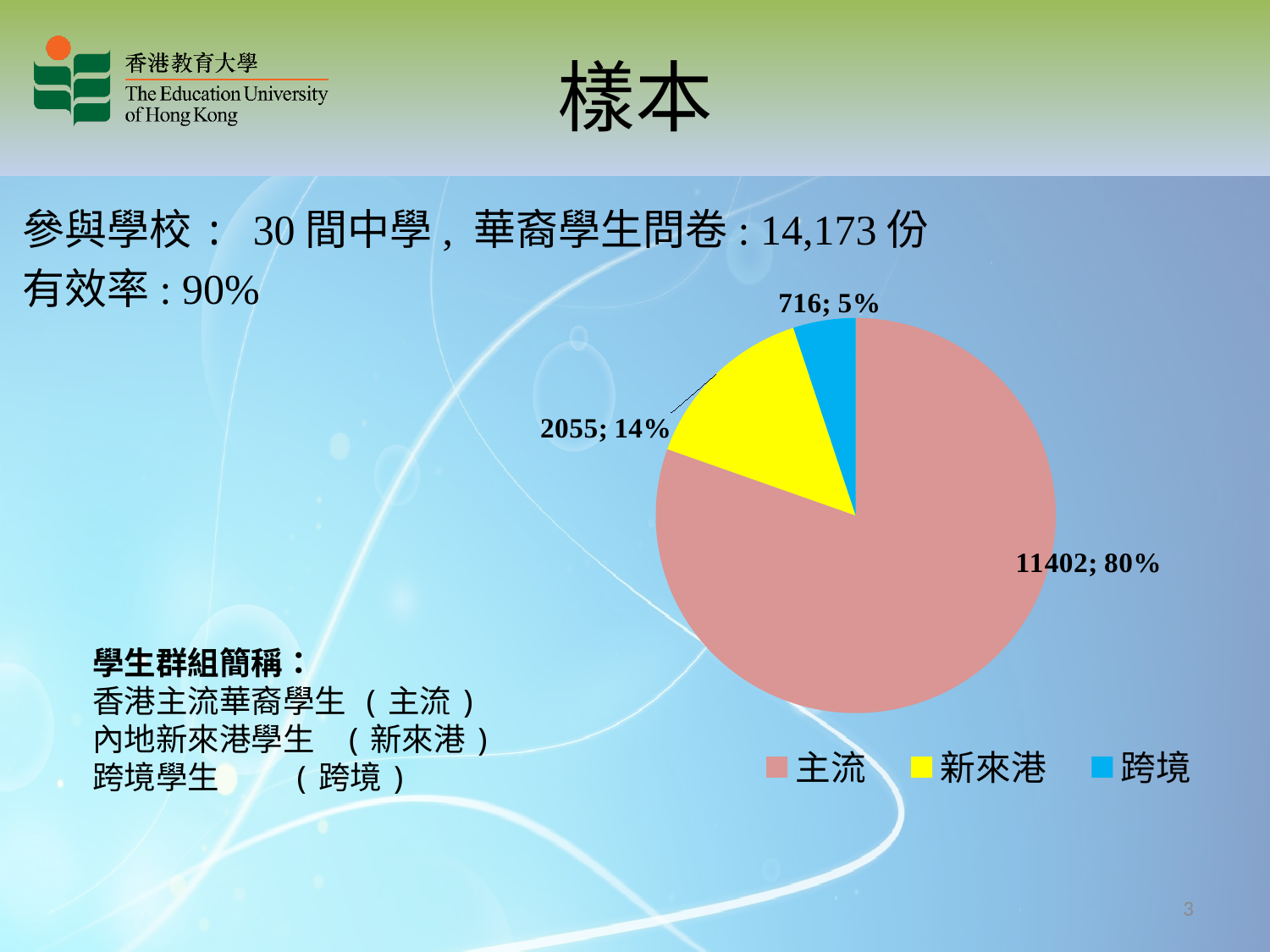
What is the difference between the values for 新來港 and 跨境 in the pie chart? 1339 What kind of chart is shown on the slide? pie chart What share of the pie does 新來港 represent? 14% How many entries does the legend of the pie chart list? 3 What is the value shown for 新來港 in the pie chart? 2055 How many slices does the pie chart have? 3 What share of the pie does 跨境 represent? 5% What is the value shown for 跨境 in the pie chart? 716 Which category has the smallest slice in the pie chart? 跨境 Which category has the largest slice in the pie chart? 主流 What is the value shown for 主流 in the pie chart? 11402 What share of the pie does 主流 represent? 80%